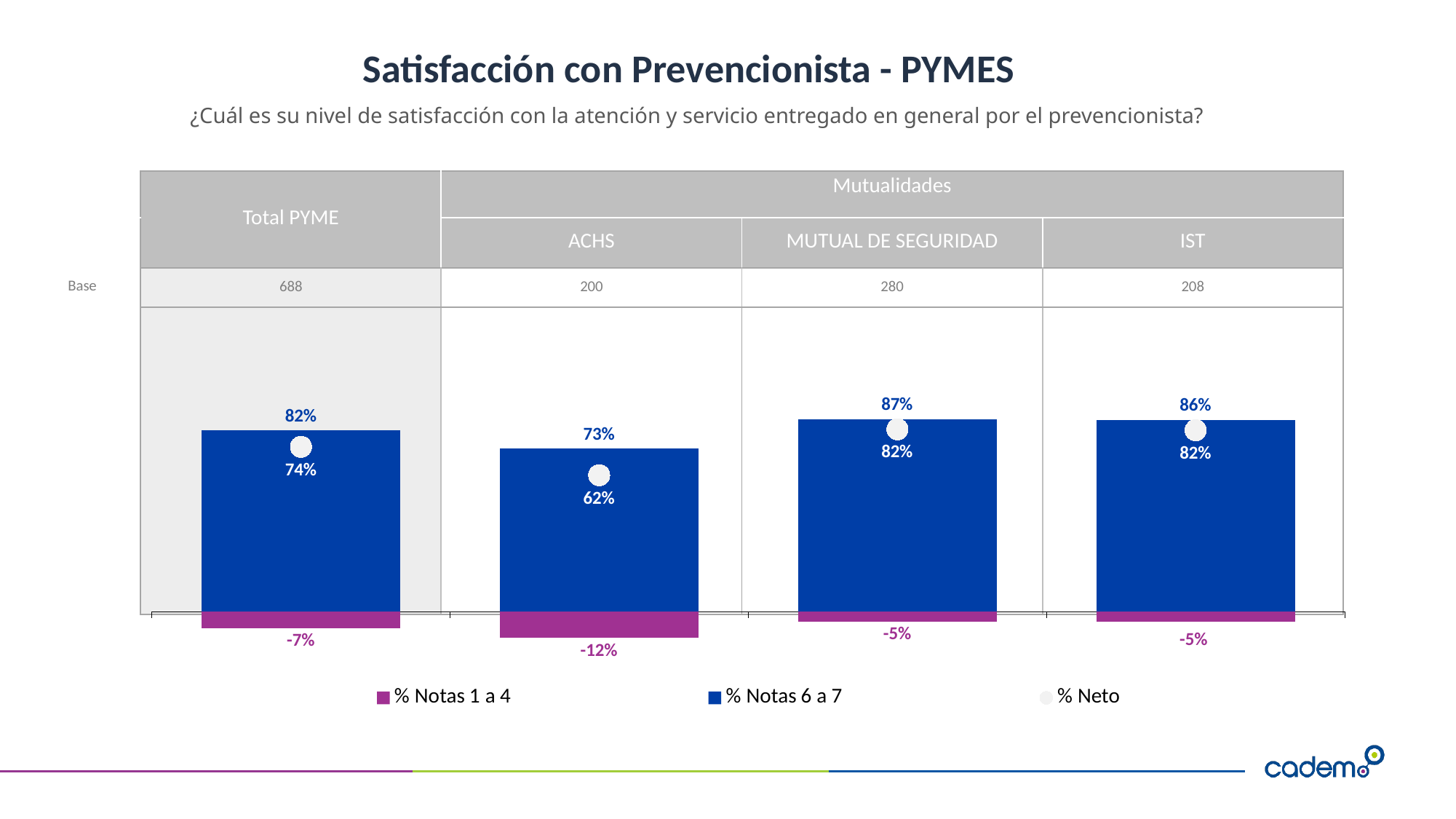
What is the % Notas 6 a 7 value for IST? 86% What kind of chart is shown on the slide? Bar chart with point markers (combination bar and line chart) How many categories are shown on the x axis of the chart? 4 What is the base (number of respondents) for MUTUAL DE SEGURIDAD? 280 What is the % Notas 1 a 4 value for ACHS? -12% What is the difference between the % Notas 6 a 7 values for MUTUAL DE SEGURIDAD and ACHS? 14% Which category has the highest % Notas 6 a 7 value? MUTUAL DE SEGURIDAD What is the % Notas 6 a 7 value for ACHS? 73% How many series does the legend list? 3 Which is larger, the % Neto value for Total PYME or for ACHS? Total PYME Which category has the lowest % Neto value? ACHS What is the % Neto value for Total PYME? 74%